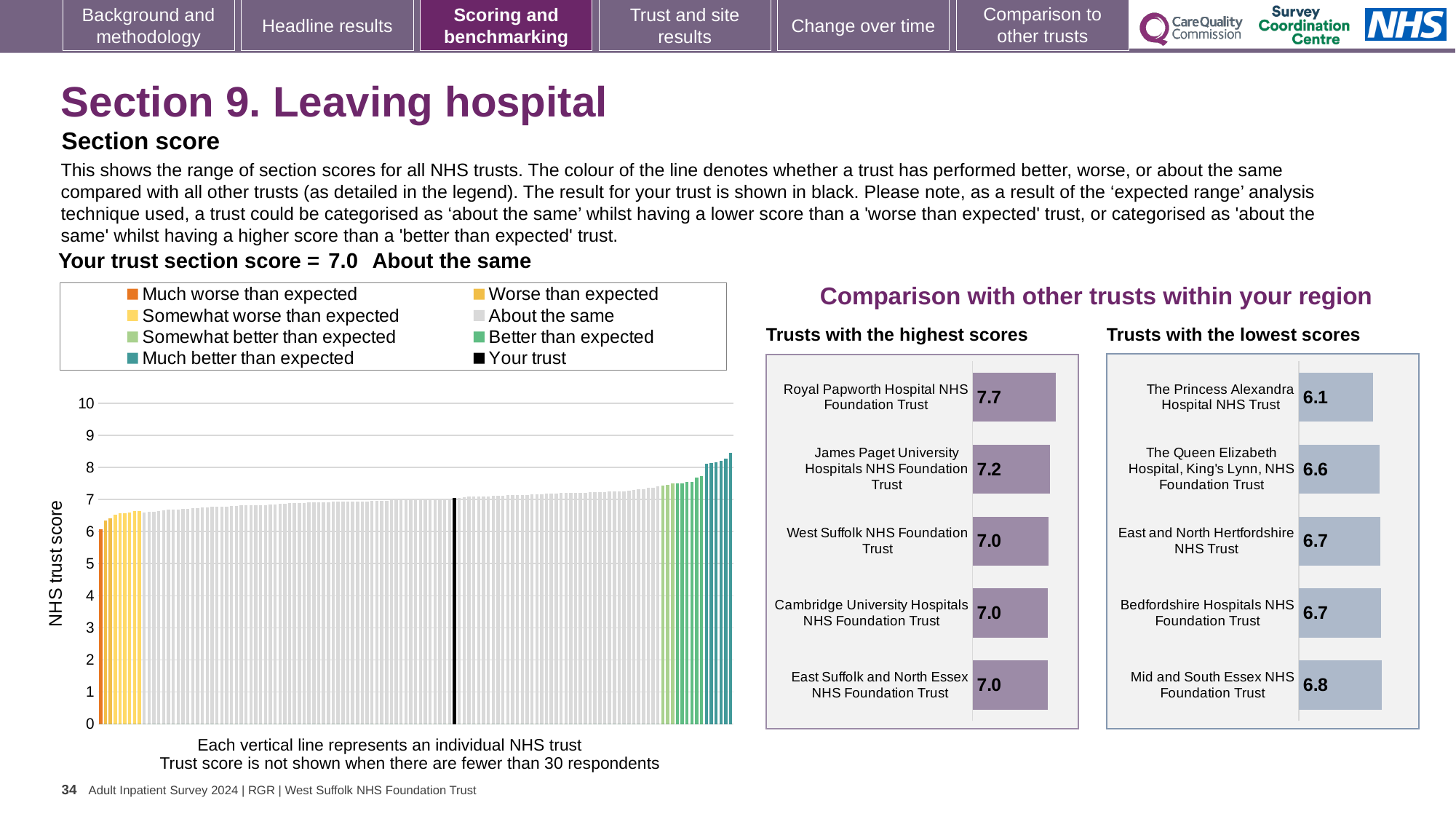
In the large 'NHS trust score' chart on the left, do the bar heights rise or fall from left to right? Rise In the large 'NHS trust score' chart on the left, is the value of the tallest bar greater or less than 8? greater In the 'Trusts with the lowest scores' chart, what is the score for The Princess Alexandra Hospital NHS Trust? 6.1 In the 'Trusts with the highest scores' chart, what is the score for Royal Papworth Hospital NHS Foundation Trust? 7.7 In the 'Trusts with the lowest scores' chart, which trust has the lowest score? The Princess Alexandra Hospital NHS Trust In the 'Trusts with the lowest scores' chart, which has the higher score: The Queen Elizabeth Hospital, King's Lynn, NHS Foundation Trust or Mid and South Essex NHS Foundation Trust? Mid and South Essex NHS Foundation Trust How many entries does the legend above the large 'NHS trust score' chart list? 8 What kind of chart is the large 'NHS trust score' chart on the left of the slide? Bar chart How many trusts are shown in the 'Trusts with the highest scores' chart? 5 In the 'Trusts with the highest scores' chart, which trust has the highest score? Royal Papworth Hospital NHS Foundation Trust In the 'Trusts with the highest scores' chart, what is the difference between the scores of Royal Papworth Hospital NHS Foundation Trust and James Paget University Hospitals NHS Foundation Trust? 0.5 According to the slide, what is your trust's section score for Section 9, Leaving hospital? 7.0